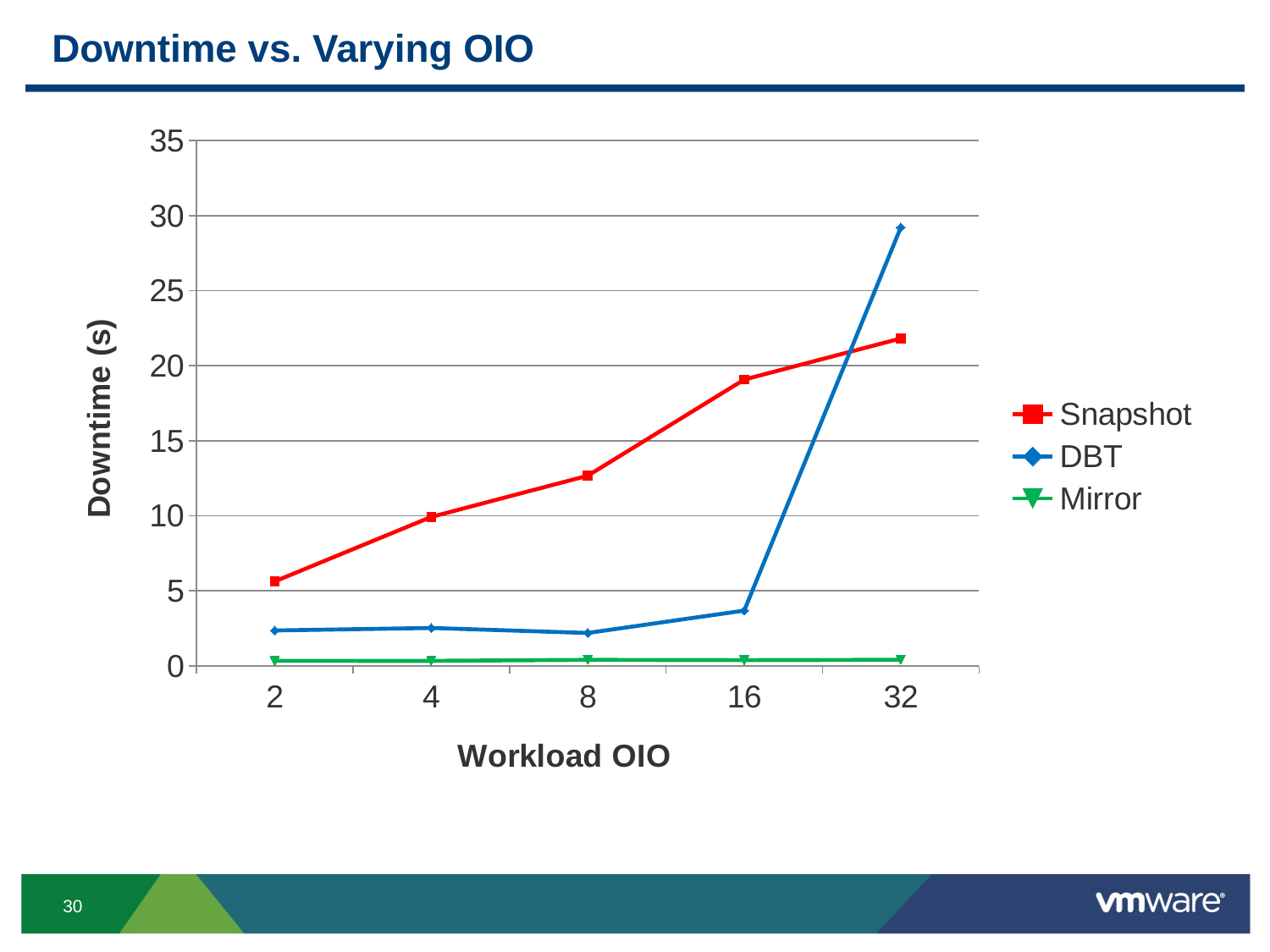
How many series does the legend list? 3 What is the title of the y axis? Downtime (s) At Workload OIO 16, which series has the larger downtime, Snapshot or DBT? Snapshot Does the Snapshot downtime rise or fall as Workload OIO increases? rise Is the Snapshot downtime at Workload OIO 32 greater or less than 20? greater Is the Snapshot downtime at Workload OIO 2 greater or less than 10? less Is the DBT downtime at Workload OIO 16 greater or less than 5? less What kind of chart is shown on the slide? line chart Which series has the lowest downtime across all Workload OIO values? Mirror How many Workload OIO values are plotted along the x axis? 5 Which series has the highest downtime at Workload OIO 32? DBT